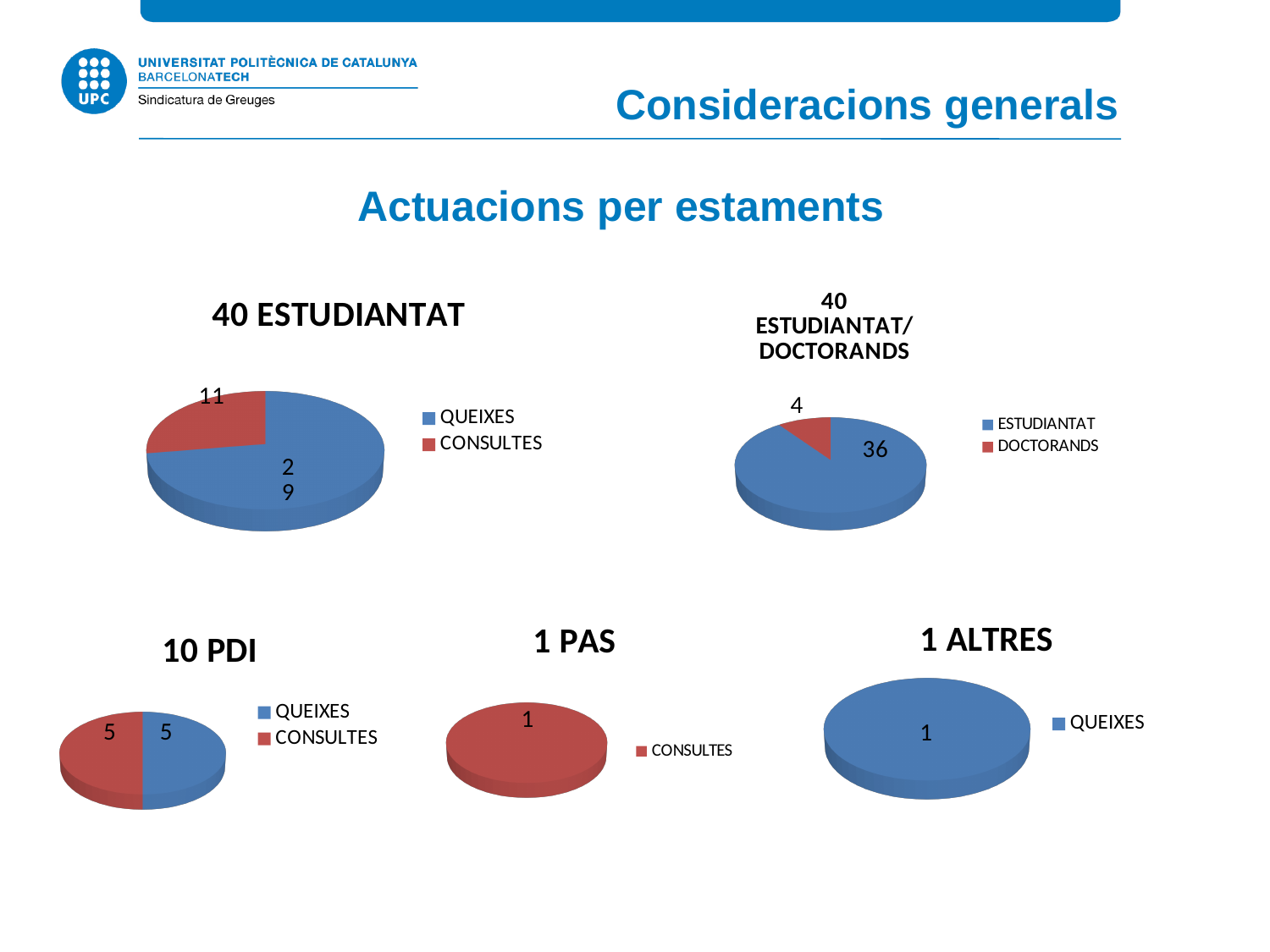
In the '10 PDI' chart, what is the value for CONSULTES? 5 In the '10 PDI' chart, what share of the pie does QUEIXES represent? 50% In the '40 ESTUDIANTAT' chart, which category is the smallest? CONSULTES In the '40 ESTUDIANTAT/DOCTORANDS' chart, what is the value for ESTUDIANTAT? 36 What kind of chart is the '1 PAS' chart? Pie chart In the '40 ESTUDIANTAT' chart, what share of the pie does CONSULTES represent? 27.5% How many categories does the legend of the '1 ALTRES' chart list? 1 In the '40 ESTUDIANTAT/DOCTORANDS' chart, which category is the largest? ESTUDIANTAT In the '40 ESTUDIANTAT/DOCTORANDS' chart, what is the difference between ESTUDIANTAT and DOCTORANDS? 32 In the '40 ESTUDIANTAT' chart, what is the value for QUEIXES? 29 In the '40 ESTUDIANTAT' chart, what is the value for CONSULTES? 11 In the '40 ESTUDIANTAT/DOCTORANDS' chart, what is the value for DOCTORANDS? 4